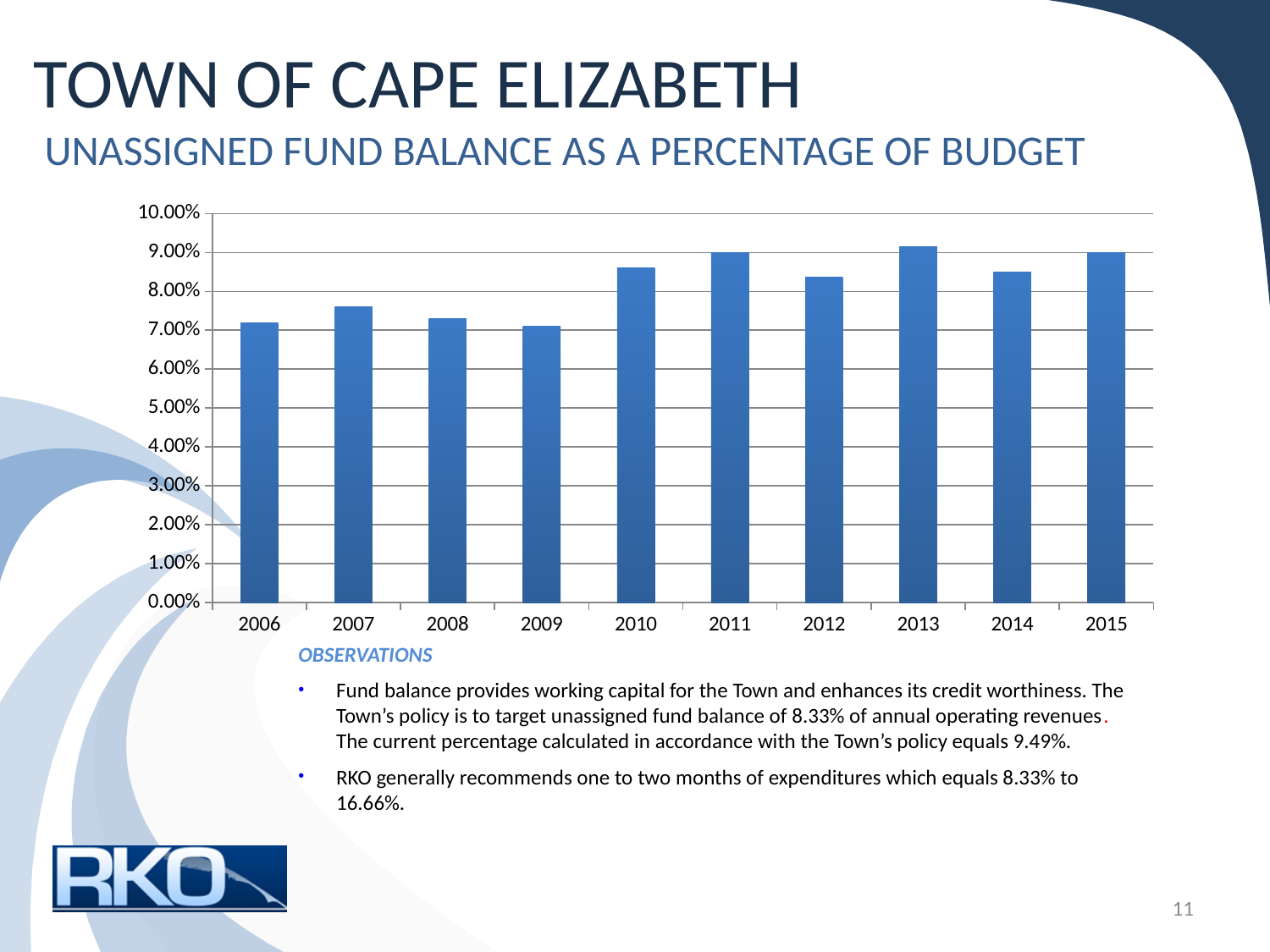
What is the subtitle describing what the chart shows? Unassigned Fund Balance as a Percentage of Budget Is the value for 2010 greater or less than 8.00%? greater Is the value for 2009 greater or less than 8.00%? less Is the value for 2006 greater or less than 8.00%? less What is the highest value shown on the y axis of the chart? 10.00% Overall, do the values rise or fall from 2006 to 2015? rise Which year has the larger value, 2007 or 2010? 2010 Which year has the larger value, 2012 or 2013? 2013 How many years are shown on the x axis of the chart? 10 Which year has the highest unassigned fund balance as a percentage of budget? 2013 What kind of chart is shown on the slide? bar chart